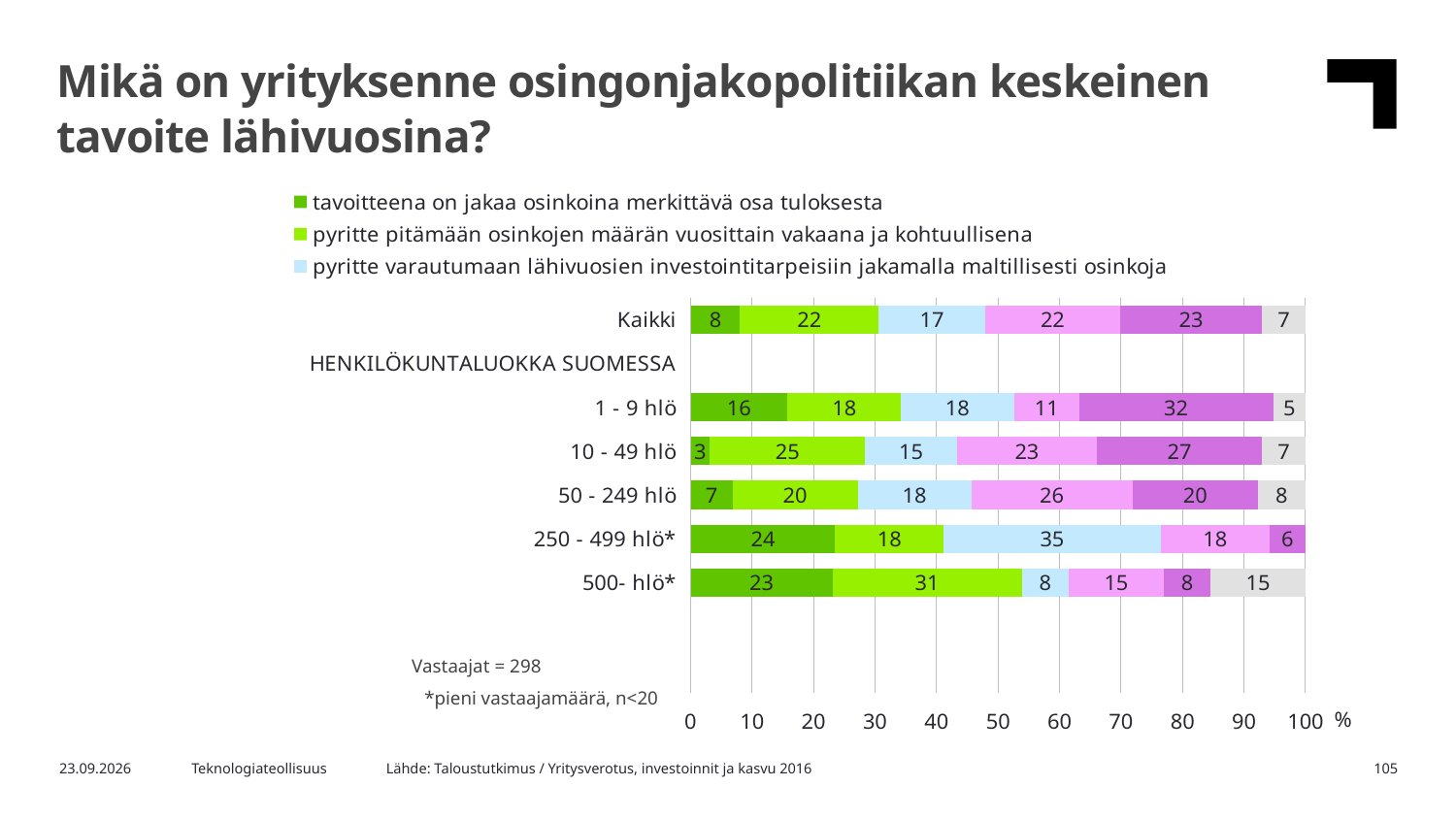
How many entries does the chart legend list? 3 What is the value of the 'pyritte pitämään osinkojen määrän vuosittain vakaana ja kohtuullisena' segment for '500- hlö*'? 31 What is the number of respondents stated below the chart (Vastaajat)? 298 What kind of chart is shown on the slide? stacked bar chart How many bars (respondent groups) are plotted in the chart? 6 What is the value of the 'pyritte varautumaan lähivuosien investointitarpeisiin jakamalla maltillisesti osinkoja' segment for '250 - 499 hlö*'? 35 What is the total of all segments in the '1 - 9 hlö' bar? 100 Which group has the lowest value for the 'tavoitteena on jakaa osinkoina merkittävä osa tuloksesta' segment? 10 - 49 hlö Which group has the highest value for the 'pyritte pitämään osinkojen määrän vuosittain vakaana ja kohtuullisena' segment? 500- hlö* What is the difference between the first (dark green) segment values of '1 - 9 hlö' and '50 - 249 hlö'? 9 What is the value of the first (dark green) segment for the 'Kaikki' bar? 8 Which is larger: the light blue segment for '1 - 9 hlö' or for '10 - 49 hlö'? 1 - 9 hlö